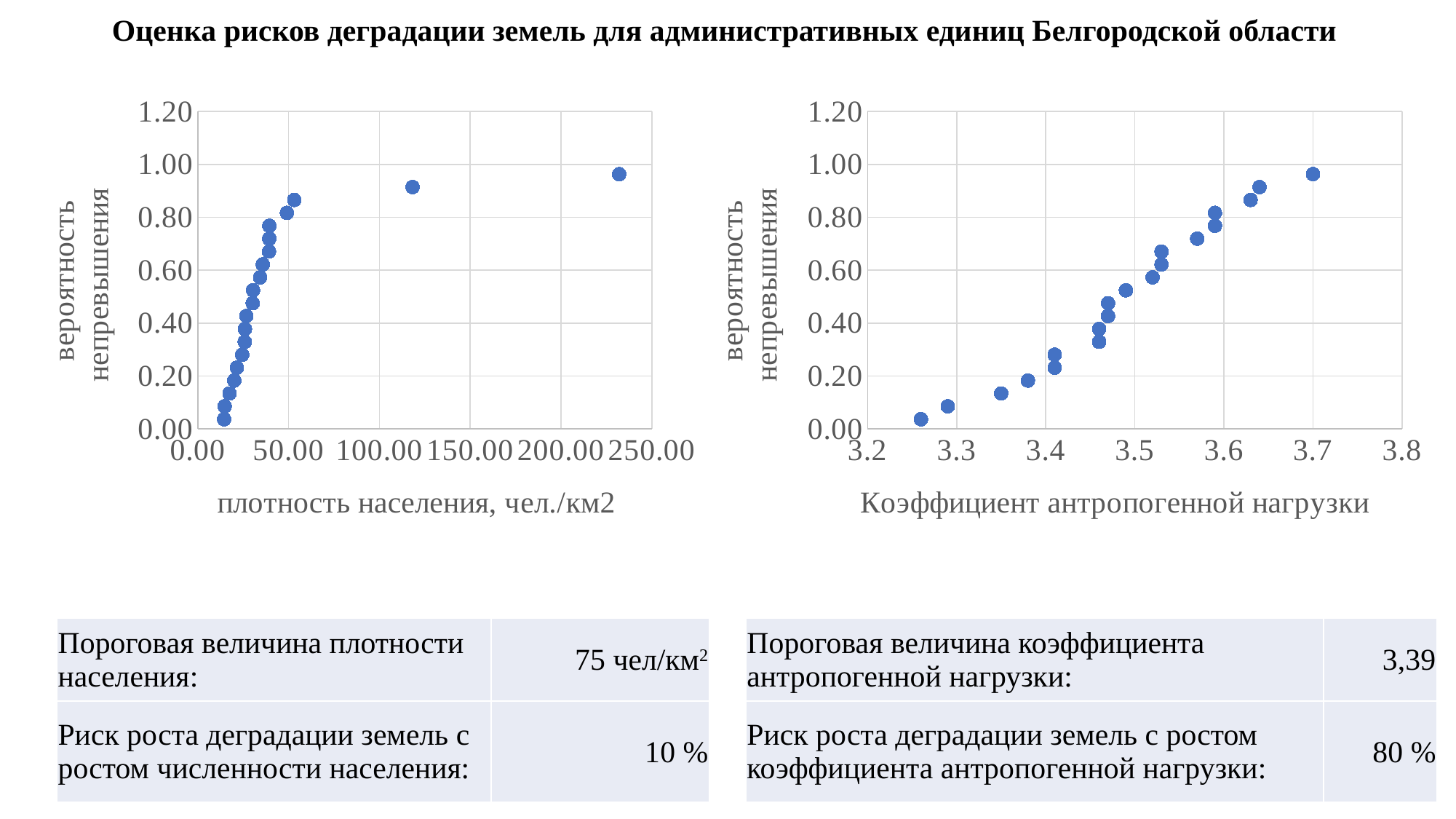
In the right chart (Коэффициент антропогенной нагрузки), is the вероятность непревышения of the point at coefficient 3.7 greater or less than 0.80? greater In the left chart (плотность населения), do the values of вероятность непревышения rise or fall as плотность населения increases? rise In the left chart (плотность населения), is the вероятность непревышения of the rightmost point greater or less than 0.80? greater In the right chart (Коэффициент антропогенной нагрузки), do the values of вероятность непревышения rise or fall as the coefficient increases? rise What is the x-axis title of the left chart? плотность населения, чел./км2 What kind of chart is the right chart (Коэффициент антропогенной нагрузки)? scatter chart In the left chart (плотность населения), is the плотность населения of the rightmost point greater or less than 200.00? greater What is the x-axis title of the right chart? Коэффициент антропогенной нагрузки What kind of chart is the left chart (плотность населения)? scatter chart